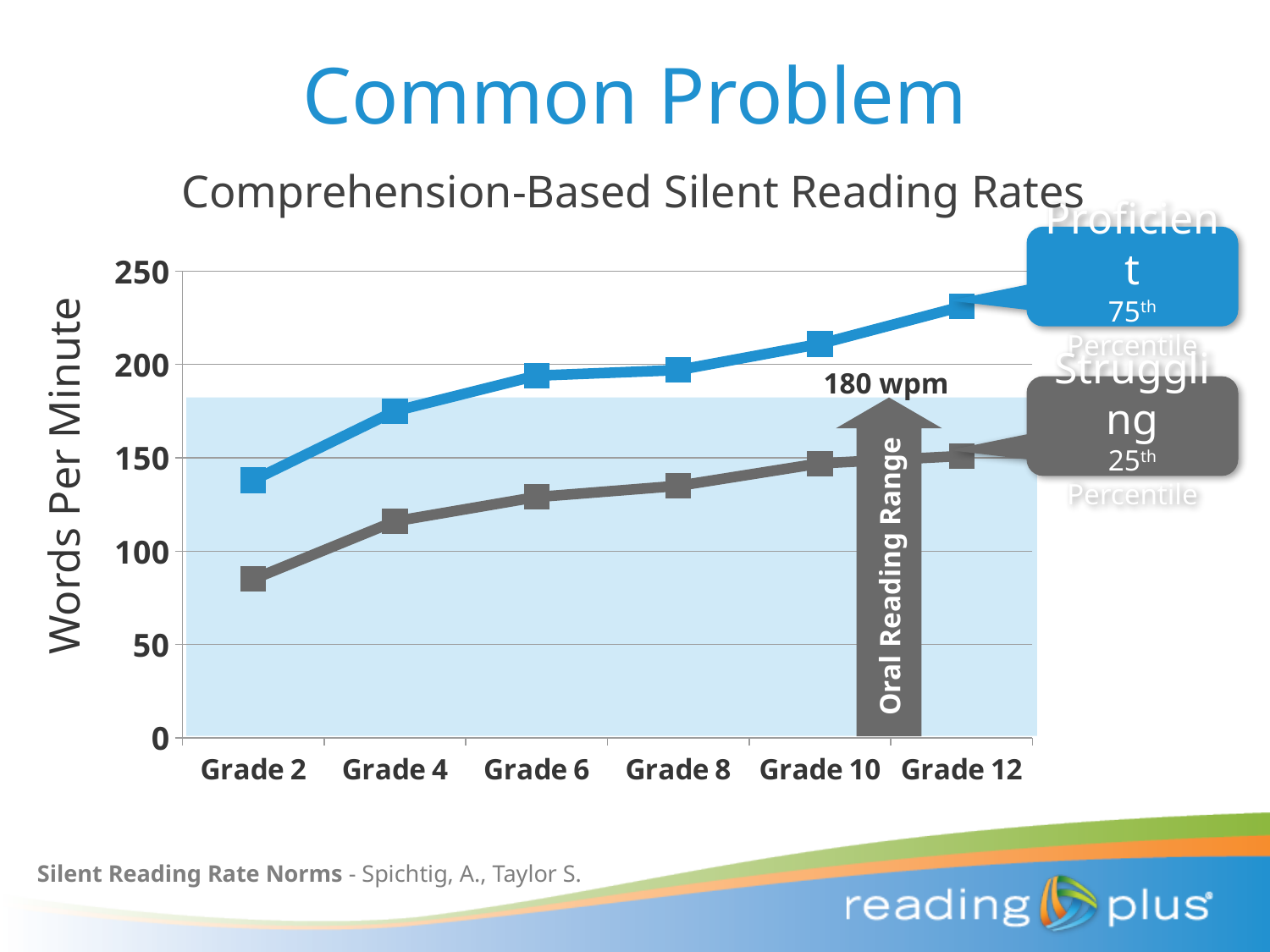
At Grade 6, which series has the higher reading rate, Proficient (75th percentile) or Struggling (25th percentile)? Proficient (75th percentile) Is the Proficient (75th percentile) value for Grade 12 greater or less than 200? greater At which grade is the Proficient (75th percentile) reading rate highest? Grade 12 What is the label on the vertical axis? Words Per Minute How many grade levels are plotted along the x axis? 6 What kind of chart is shown on the slide? line chart How many data series (lines) are plotted on the chart? 2 Is the Proficient (75th percentile) value for Grade 2 greater or less than 150? less What is the title of the chart? Comprehension-Based Silent Reading Rates Do the Proficient (75th percentile) values rise or fall from Grade 2 to Grade 12? rise Is the Struggling (25th percentile) value for Grade 2 greater or less than 100? less At which grade is the Struggling (25th percentile) reading rate lowest? Grade 2